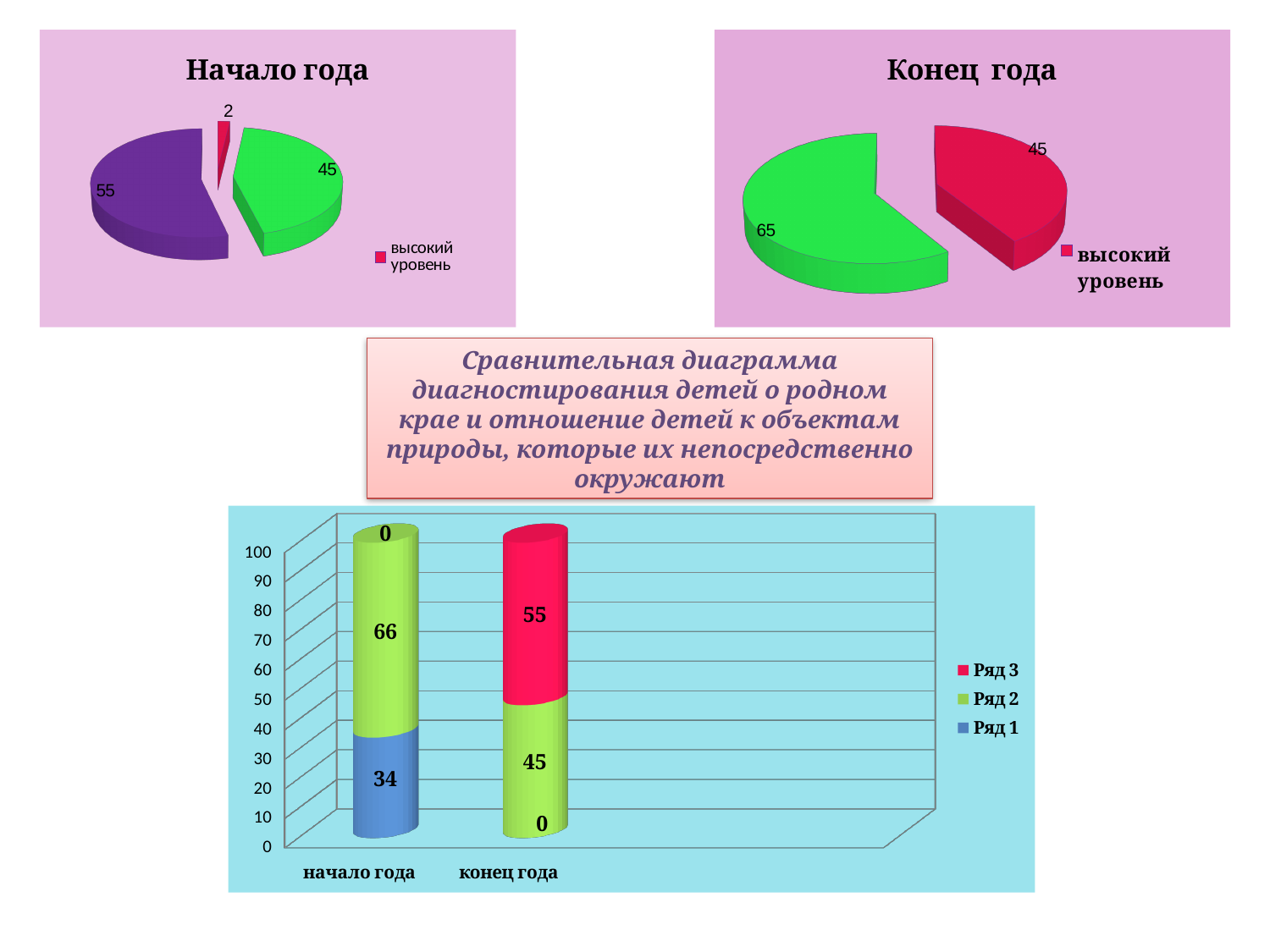
In the pie chart titled "Начало года", what is the value of the largest slice? 55 In the bar chart at the bottom of the slide, how many series does the legend list? 3 In the bar chart at the bottom of the slide, what is the value of Ряд 1 for "начало года"? 34 What kind of chart is shown at the bottom of the slide? Stacked bar chart In the bar chart at the bottom of the slide, what is the value of Ряд 2 for "начало года"? 66 In the pie chart titled "Конец года", what is the difference between the two slice values? 20 In the pie chart titled "Конец года", what value is shown for the slice labelled "высокий уровень"? 45 In the pie chart titled "Начало года", what value is shown for the slice labelled "высокий уровень"? 2 In the bar chart at the bottom of the slide, what is the total of the stacked bar for "конец года"? 100 In the bar chart at the bottom of the slide, what is the value of Ряд 3 for "конец года"? 55 In the pie chart titled "Начало года", how many slices does the pie have? 3 In the pie chart titled "Конец года", what is the value of the largest slice? 65